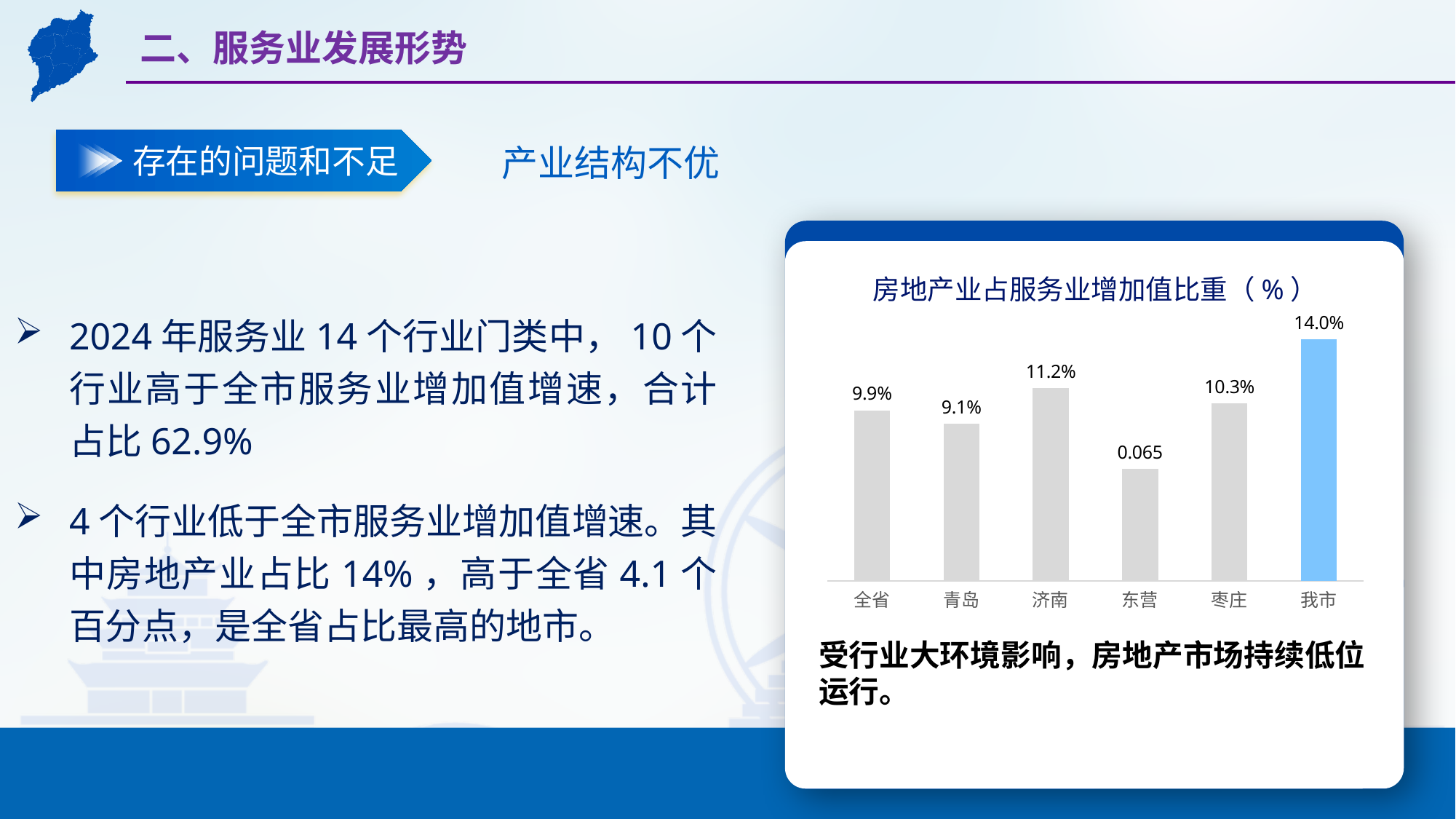
What is the value shown for 枣庄? 10.3% What kind of chart is shown on the slide? Bar chart What is the value for 全省 in the chart? 9.9% Which category has the lowest bar in the chart? 东营 How many categories are shown on the x axis of the chart? 6 Which is larger, the value for 济南 or the value for 枣庄? 济南 What is the value shown for 青岛? 9.1% Which category has the highest value in the chart? 我市 What is the value shown for 济南? 11.2% What is the value for 我市 in the chart 房地产业占服务业增加值比重（%）? 14.0% What data label is shown for 东营? 0.065 By how many percentage points does 我市 exceed 全省? 4.1